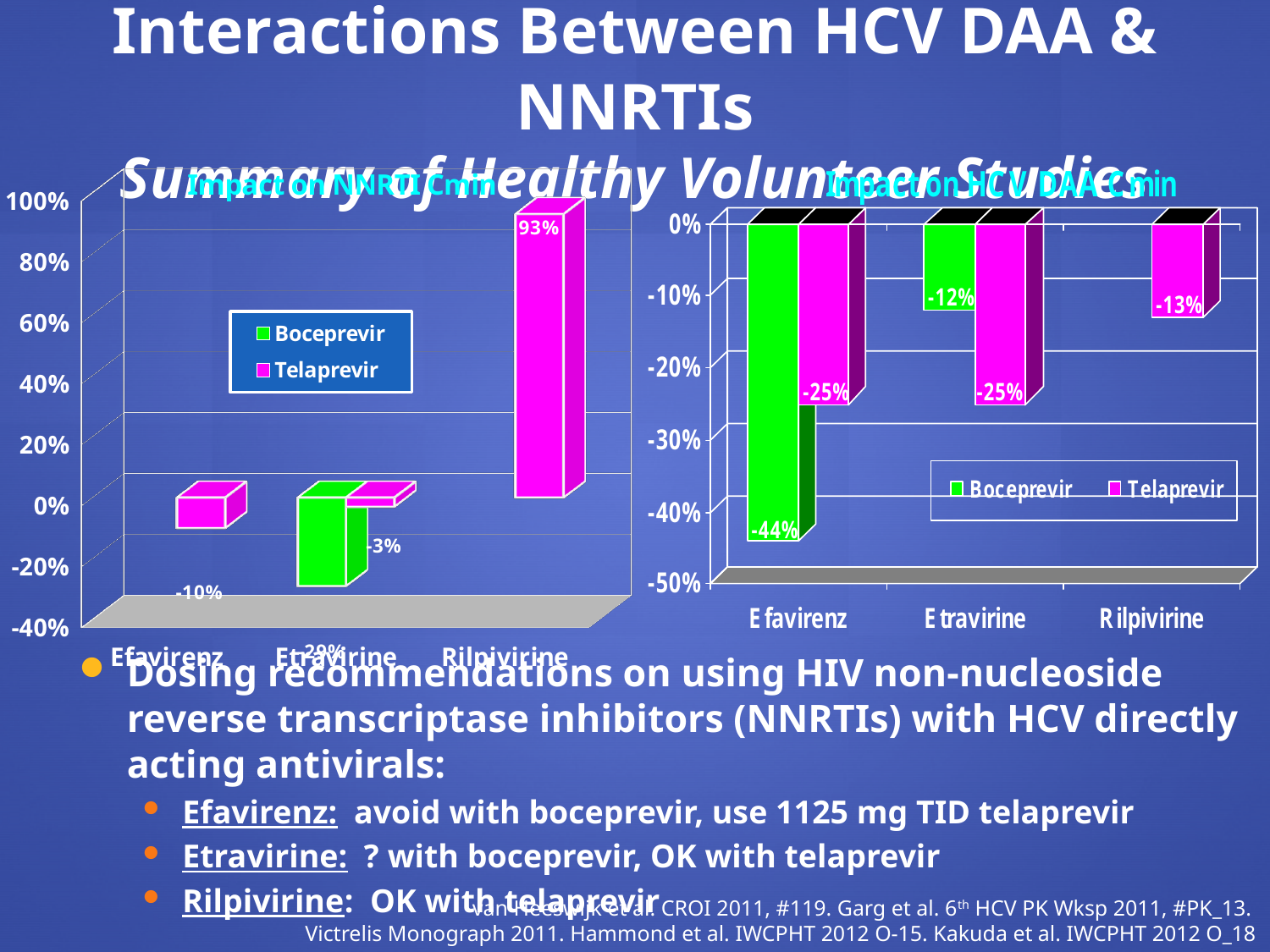
What kind of chart is the 'Impact on NNRTI Cmin' chart? Bar chart In the 'Impact on HCV DAA Cmin' chart, which NNRTI has the lowest Boceprevir value? Efavirenz How many NNRTI categories are shown on the x axis of the 'Impact on HCV DAA Cmin' chart? 3 In the 'Impact on HCV DAA Cmin' chart, what is the difference between the Boceprevir and Telaprevir values for Efavirenz? 19 percentage points In the 'Impact on HCV DAA Cmin' chart, what is the Boceprevir value for Efavirenz? -44% In the 'Impact on HCV DAA Cmin' chart, for Etravirine, which series has the lower value, Boceprevir or Telaprevir? Telaprevir In the 'Impact on HCV DAA Cmin' chart, what is the Telaprevir value for Efavirenz? -25% In the 'Impact on NNRTI Cmin' chart, what is the Telaprevir value for Rilpivirine? 93% In the 'Impact on HCV DAA Cmin' chart, what is the Telaprevir value for Rilpivirine? -13% In the 'Impact on NNRTI Cmin' chart, what is the Telaprevir value for Etravirine? -3% How many series does the legend of the 'Impact on HCV DAA Cmin' chart list? 2 In the 'Impact on HCV DAA Cmin' chart, what is the Boceprevir value for Etravirine? -12%